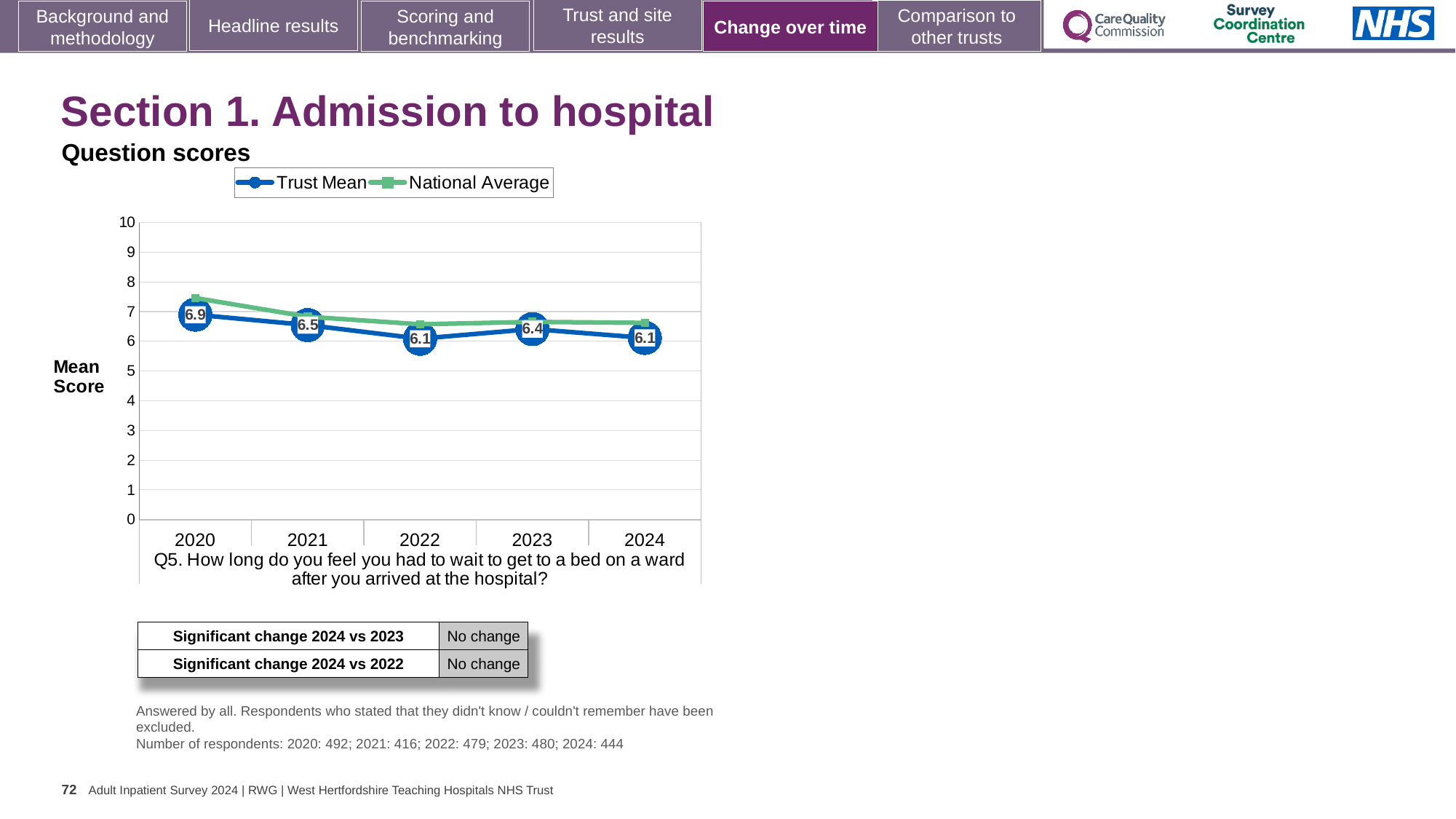
Does the Trust Mean score rise or fall from 2020 to 2022? Fall What is the lowest Trust Mean score shown on the chart? 6.1 What kind of chart is shown on the slide? Line chart What is the difference between the Trust Mean scores for 2020 and 2024? 0.8 How many years are plotted on the x axis? 5 Which year has the larger Trust Mean score, 2021 or 2023? 2021 Is the National Average value for 2020 greater or less than 7? greater What is the Trust Mean score for 2020? 6.9 How many series does the legend list? 2 What is the Trust Mean score for 2024? 6.1 What is the Trust Mean score for 2023? 6.4 In which year is the Trust Mean score highest? 2020